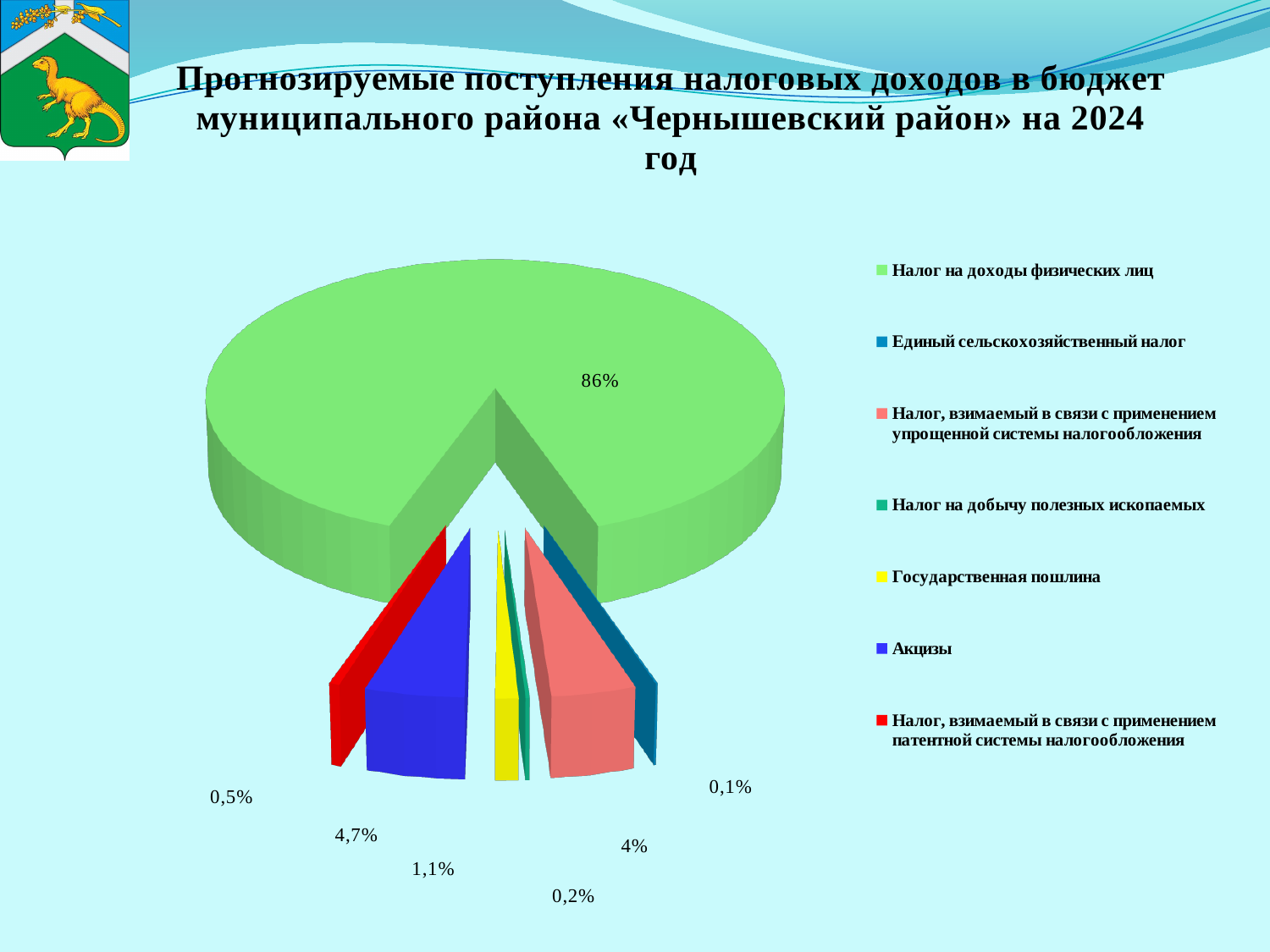
What share of the pie does «Государственная пошлина» have? 1,1% What is the difference between the share for «Налог на доходы физических лиц» and the share for «Акцизы»? 81,3% What share of the pie does «Единый сельскохозяйственный налог» have? 0,1% Which category has the smallest slice of the pie? Единый сельскохозяйственный налог Which is larger: the share for «Акцизы» or the share for «Налог, взимаемый в связи с применением упрощенной системы налогообложения»? Акцизы What share of the pie does «Налог, взимаемый в связи с применением упрощенной системы налогообложения» have? 4% What colour is the slice for «Налог на доходы физических лиц»? green What share of the pie does «Налог на доходы физических лиц» have? 86% What kind of chart is shown on the slide? pie chart What share of the pie does «Акцизы» have? 4,7% Which category has the largest slice of the pie? Налог на доходы физических лиц How many categories does the legend of the pie chart list? 7